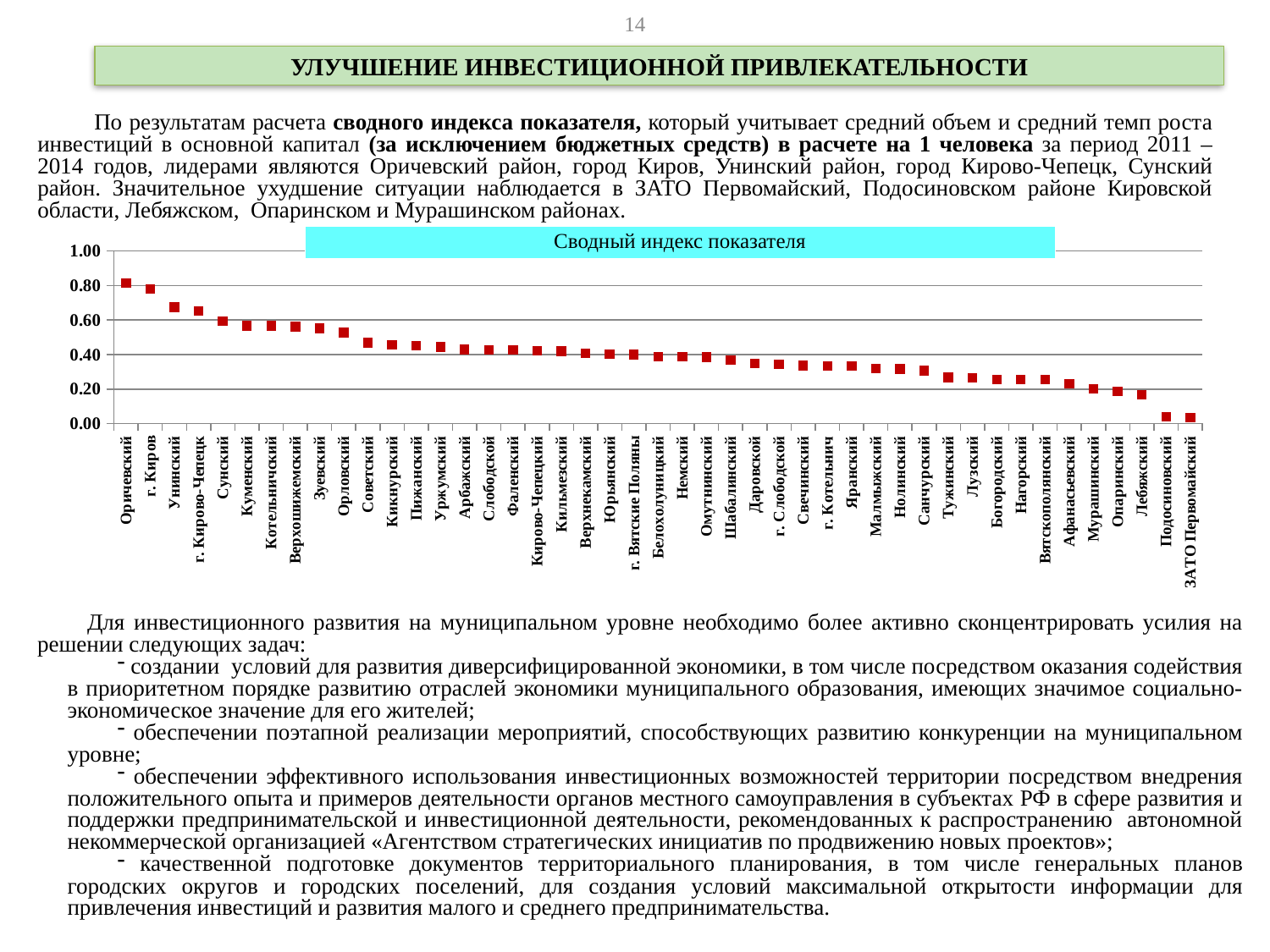
Is the value for Оричевский greater or less than 0.60? greater What is the title of the chart? Сводный индекс показателя Which has the larger value, г. Киров or Сунский? г. Киров Which category has the highest value in the chart? Оричевский What colour are the data markers in the chart? red Do the values rise or fall from left to right along the x axis? fall How many categories are plotted on the x axis? 45 Which has the larger value, Лебяжский or Оричевский? Оричевский Is the value for Подосиновский greater or less than 0.20? less Is the value for Зуевский greater or less than 0.40? greater